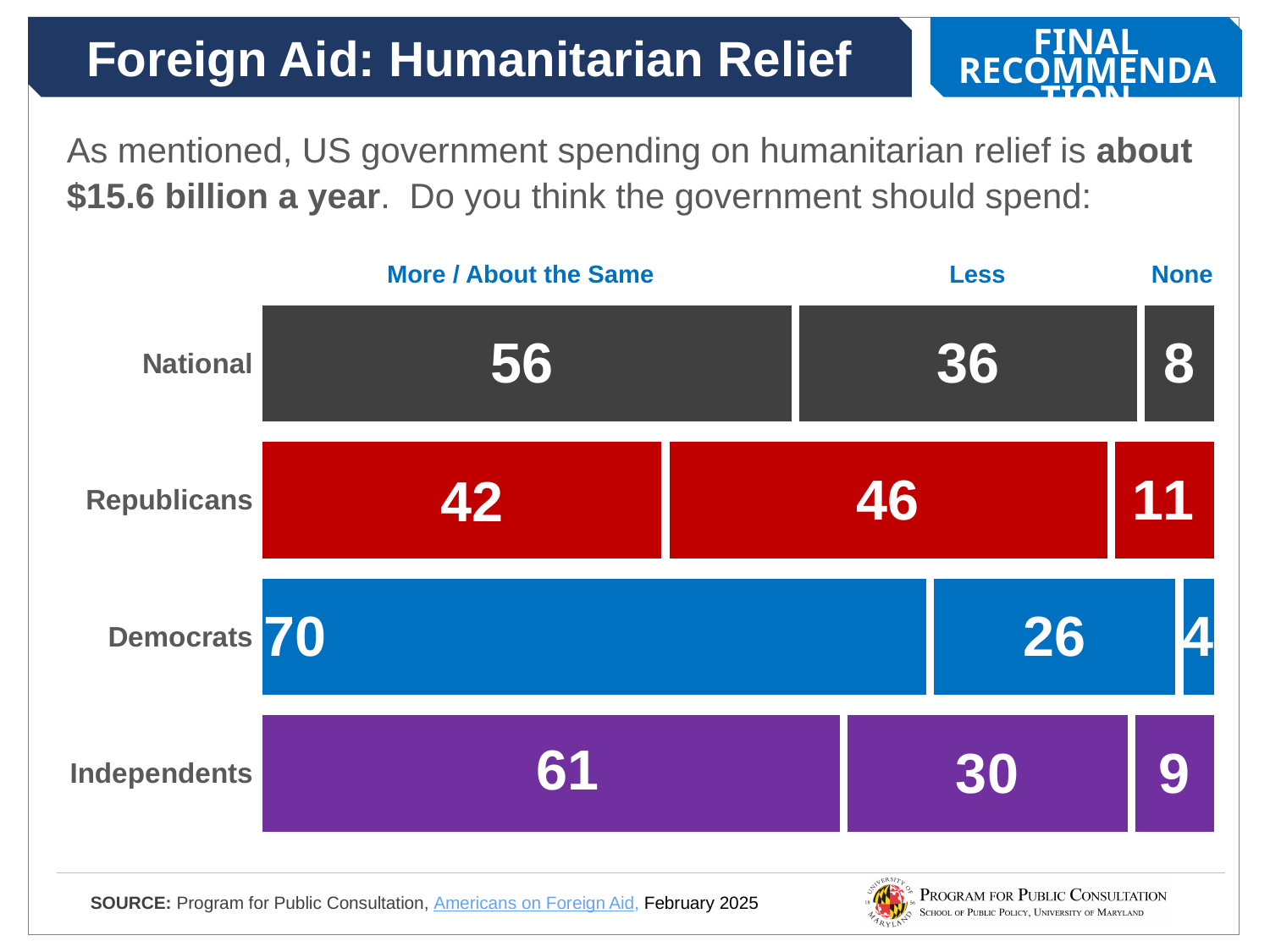
What kind of chart is shown on the slide? Stacked bar chart What is the Republicans value for None? 11 Which is larger for Republicans: More / About the Same or Less? Less Which group has the highest value for More / About the Same? Democrats What percentage of Democrats say the government should spend More / About the Same on humanitarian relief? 70 Which group has the lowest value for None? Democrats What is the difference between the Republicans and Democrats values for Less? 20 What is the total of the Independents bar? 100 What is the Independents value for More / About the Same? 61 How many groups (bars) are shown in the chart? 4 What is the National value for Less? 36 How many response categories does the chart show? 3